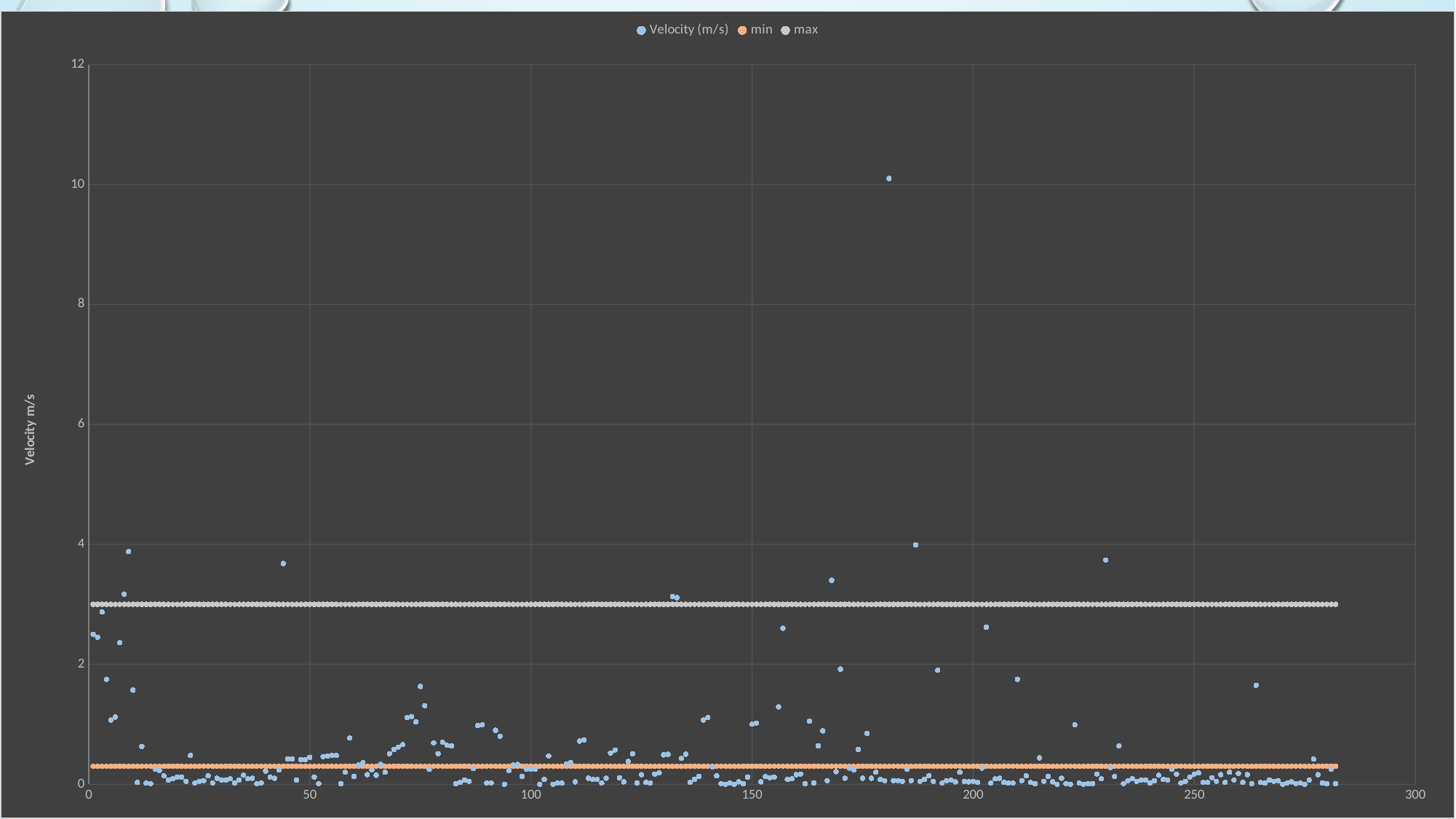
Do most of the Velocity (m/s) points lie above or below the max line? below How many series does the legend list? 3 Is the value of the max series greater or less than 4? less Which series has the higher constant value, min or max? max Is the value of the min series greater or less than 2? less Is the highest Velocity (m/s) point on the chart greater or less than 8? greater What is the highest value shown on the vertical axis? 12 What is the title of the vertical axis? Velocity m/s What kind of chart is shown on the slide? scatter chart What are the three series named in the legend? Velocity (m/s), min, max